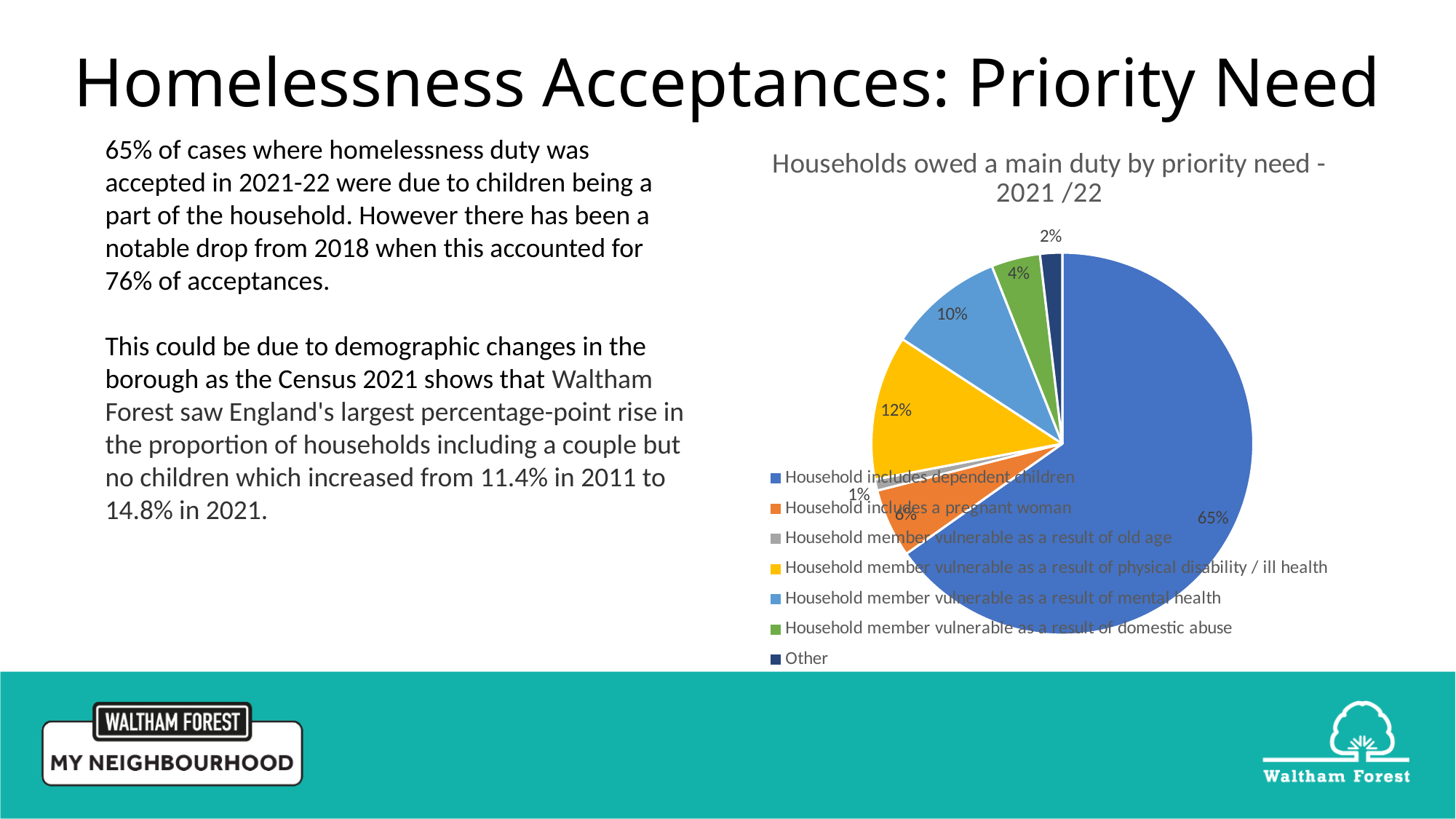
What share of the pie is 'Household member vulnerable as a result of mental health'? 10% What percentage is shown for 'Other'? 2% What is the title of the chart? Households owed a main duty by priority need - 2021 /22 What percentage is shown for 'Household member vulnerable as a result of domestic abuse'? 4% How many categories does the legend list? 7 What share of households owed a main duty is for 'Household includes dependent children'? 65% What is the difference in percentage points between 'Household member vulnerable as a result of physical disability / ill health' and 'Household member vulnerable as a result of mental health'? 2 percentage points What percentage is shown for 'Household includes a pregnant woman'? 6% What share of the pie is 'Household member vulnerable as a result of physical disability / ill health'? 12% What type of chart is shown on the slide? Pie chart Which priority need category has the largest share of the pie? Household includes dependent children Which priority need category has the smallest share of the pie? Household member vulnerable as a result of old age